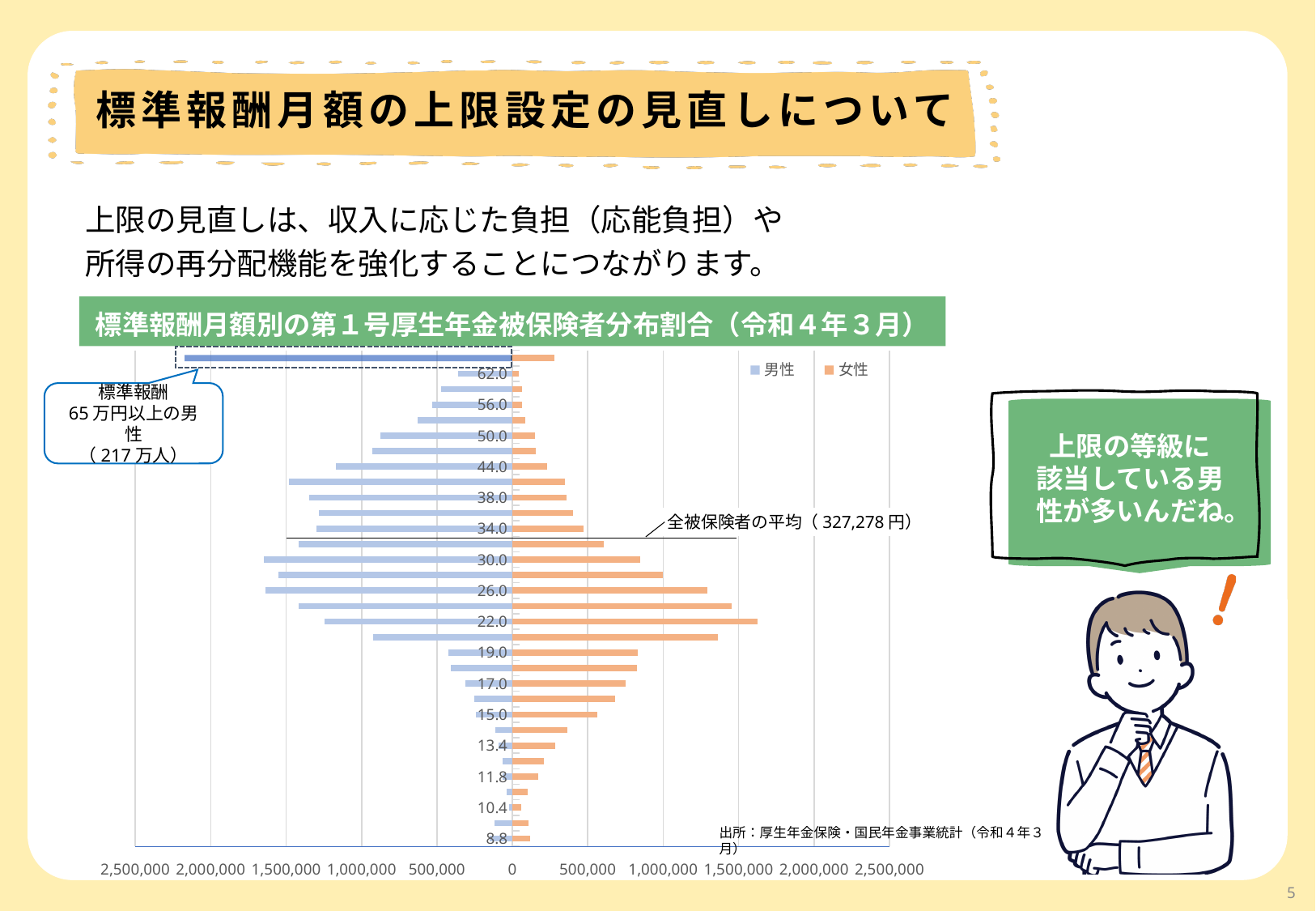
What is the average standard monthly remuneration of all insured persons shown on the chart? 327,278円 Is the value for 女性 at the 22.0 grade greater or less than 1,000,000? greater How many series does the chart legend list? 2 Is the value for 男性 in the top (65万円以上) grade greater or less than 2,000,000? greater For the 男性 series, which grade has the highest value? 65万円以上 (the top grade) What are the two series named in the chart legend? 男性 and 女性 What is the title of the chart? 標準報酬月額別の第１号厚生年金被保険者分布割合（令和４年３月） At the 22.0 grade, which series has the larger value, 男性 or 女性? 女性 Is the value for 女性 at the 62.0 grade greater or less than 500,000? less What kind of chart is shown on the slide? bar chart For the 女性 series, which grade has the highest value? 22.0 According to the callout on the chart, how many men are in the 65万円以上 standard remuneration grade? 217万人